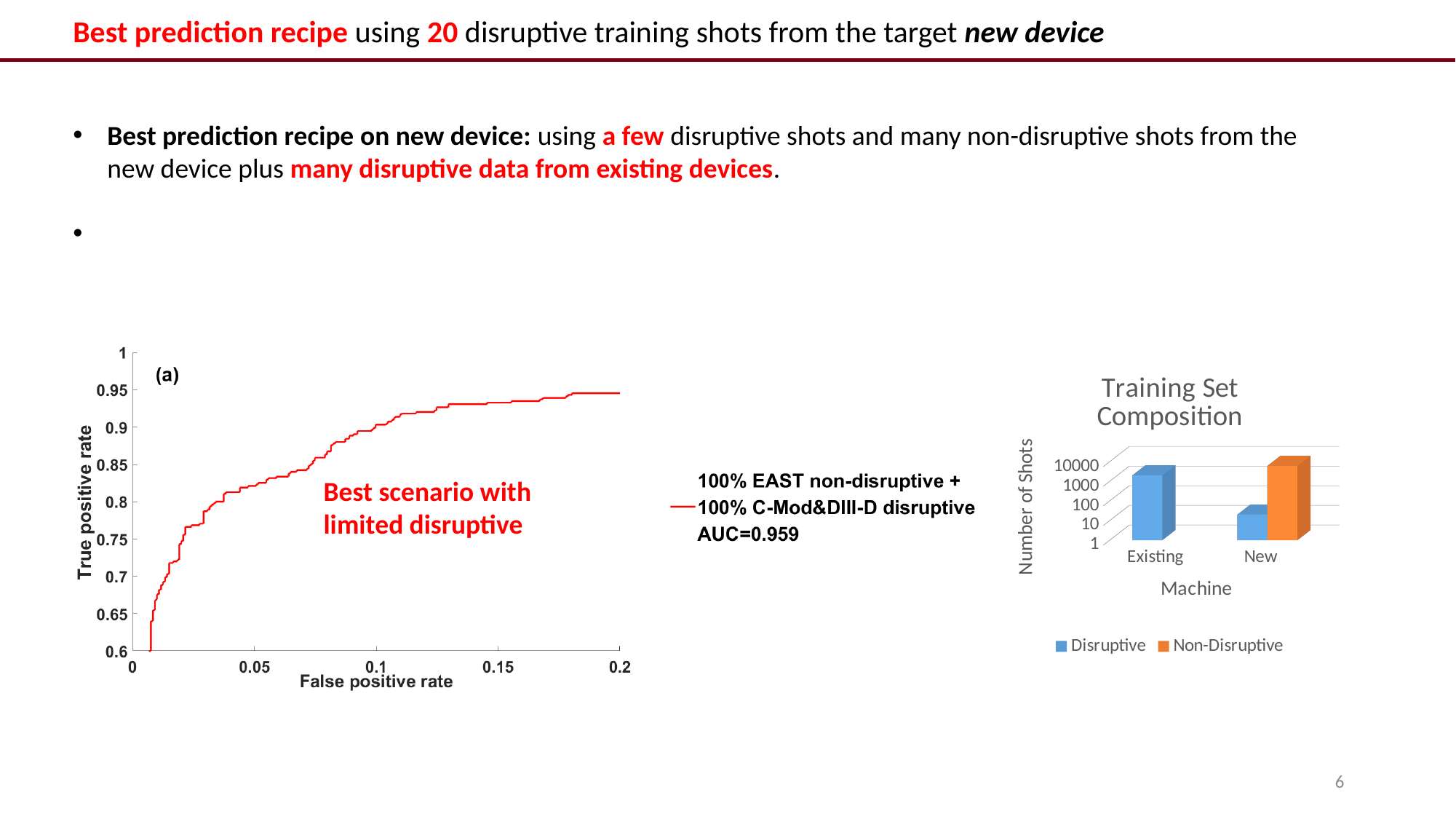
In the chart on the left of the slide, does the True positive rate rise or fall as the False positive rate increases? rise In the Training Set Composition chart, is the Disruptive value for New greater or less than 100? less What AUC value is given in the legend of the chart on the left of the slide? AUC=0.959 In the Training Set Composition chart, how many series does the legend list? 2 What is the y-axis title of the Training Set Composition chart? Number of Shots What kind of chart is the Training Set Composition chart on the right of the slide? bar chart In the Training Set Composition chart, for the New machine, which series has the larger value, Disruptive or Non-Disruptive? Non-Disruptive In the Training Set Composition chart, which machine has the larger Disruptive value, Existing or New? Existing What kind of chart is the chart on the left of the slide with True positive rate on the y axis? line chart In the Training Set Composition chart, is the Disruptive value for New greater or less than 10? greater In the Training Set Composition chart, how many machine categories are shown on the x axis? 2 In the Training Set Composition chart, is the Disruptive value for Existing greater or less than 1000? greater